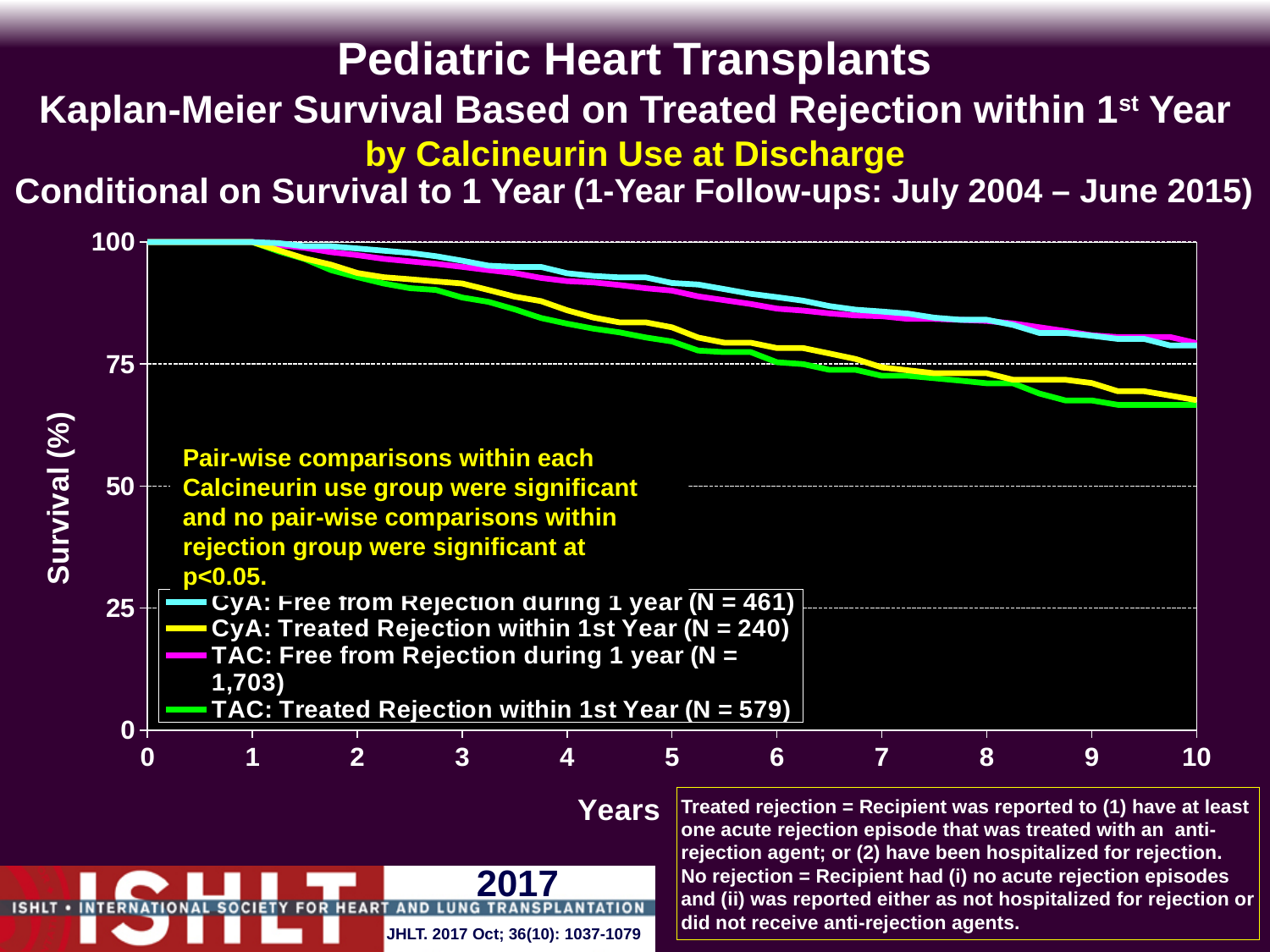
Is the survival value for 'TAC: Treated Rejection within 1st Year' at year 10 greater or less than 75? less Is the survival value for 'CyA: Treated Rejection within 1st Year' at year 5 greater or less than 75? greater At year 10, which series has higher survival: 'CyA: Free from Rejection during 1 year' or 'TAC: Treated Rejection within 1st Year'? CyA: Free from Rejection during 1 year Is the survival value for 'TAC: Free from Rejection during 1 year' at year 3 greater or less than 75? greater Which series has the lowest survival at year 10? TAC: Treated Rejection within 1st Year What kind of chart is shown on the slide? Line chart What is the label of the y-axis? Survival (%) How many series does the legend list? 4 What is the label of the x-axis? Years Do the survival curves rise or fall as years increase along the x axis? Fall What is the N for the 'TAC: Free from Rejection during 1 year' series shown in the legend? 1,703